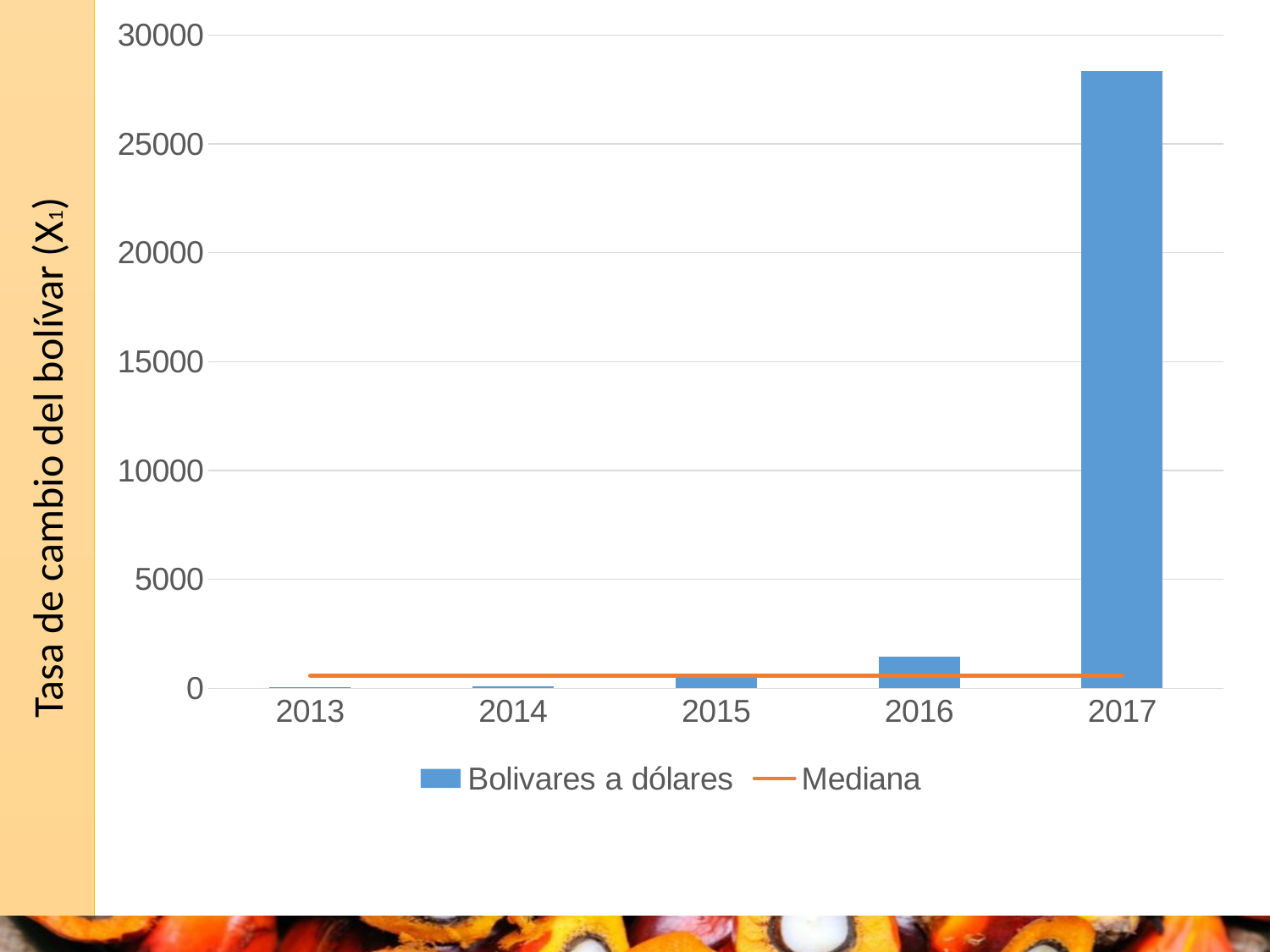
What kind of chart is shown on the slide? combination bar and line chart Is the value for Bolivares a dólares in 2016 greater or less than 5000? less What are the two entries listed in the chart's legend? Bolivares a dólares and Mediana Is the value for Bolivares a dólares in 2017 greater or less than 25000? greater How many series does the chart's legend list? 2 Which is larger, the Bolivares a dólares value for 2015 or for 2016? 2016 Is the value for Bolivares a dólares in 2015 greater or less than 5000? less Do the Bolivares a dólares values rise or fall from 2013 to 2017? rise Which year has the highest value for Bolivares a dólares? 2017 What is the label of the vertical axis of the chart? Tasa de cambio del bolívar (X1) How many years are shown on the x axis of the chart? 5 Which is larger, the Bolivares a dólares value for 2016 or for 2017? 2017